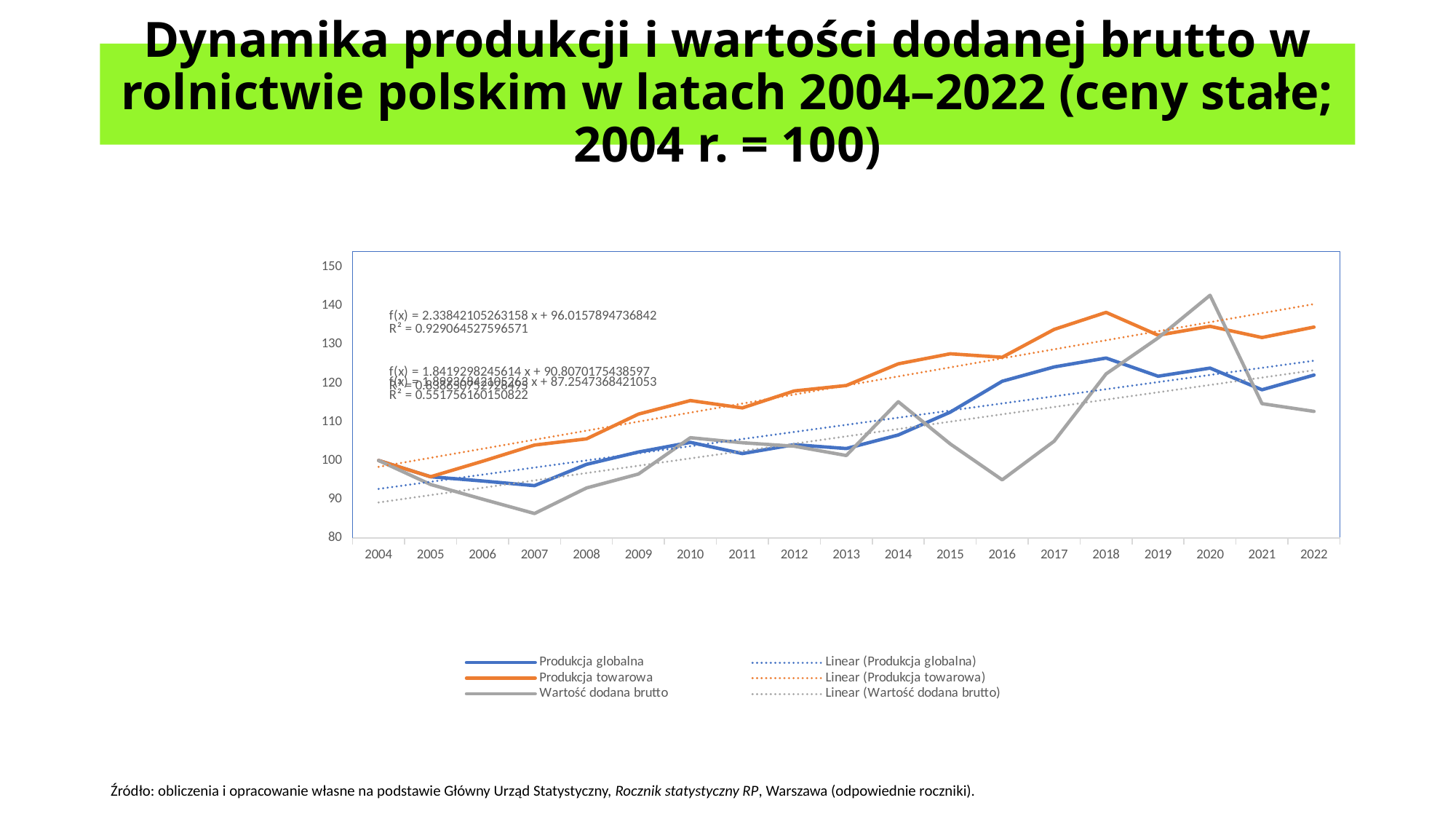
Is the value for Wartość dodana brutto in 2007 greater or less than 90? less Is the value for Wartość dodana brutto in 2016 greater or less than 100? less In which year is Wartość dodana brutto at its lowest? 2007 What kind of chart is shown on the slide? line chart In which year does Wartość dodana brutto reach its highest value? 2020 How many years are plotted along the x axis? 19 How many entries does the legend list? 6 Does Produkcja towarowa generally rise or fall from 2004 to 2022? rise In 2020, which is larger: Wartość dodana brutto or Produkcja towarowa? Wartość dodana brutto In which year does Produkcja towarowa reach its highest value? 2018 Is the value for Produkcja towarowa in 2018 greater or less than 130? greater What is the value of Produkcja globalna in 2004? 100